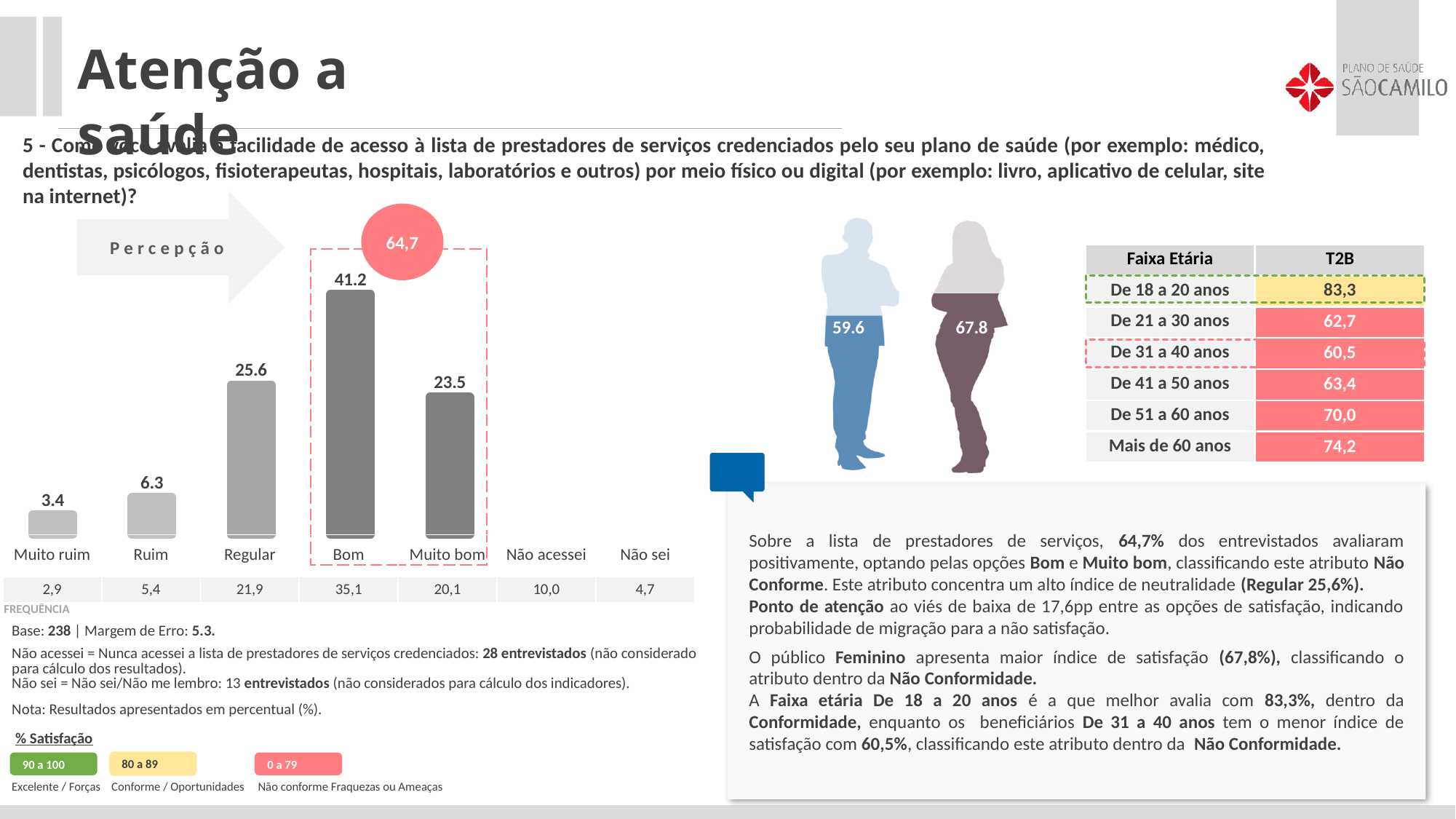
What value is shown in the red circle above the Bom and Muito bom bars? 64,7 What is the value shown for the Regular bar in the chart? 25.6 Which category has the lowest bar in the chart? Muito ruim What kind of chart is shown on the slide? Bar chart What is the difference between the Bom and Muito bom values in the chart? 17.7 Which category has the highest bar in the chart? Bom How many bars are plotted in the chart? 5 What is the difference between the Regular and Ruim values in the chart? 19.3 What is the value shown for the Muito ruim bar in the chart? 3.4 What is the value shown for the Ruim bar in the chart? 6.3 What is the value shown for the Bom bar in the chart? 41.2 Which is larger in the chart, the value for Regular or the value for Muito bom? Regular